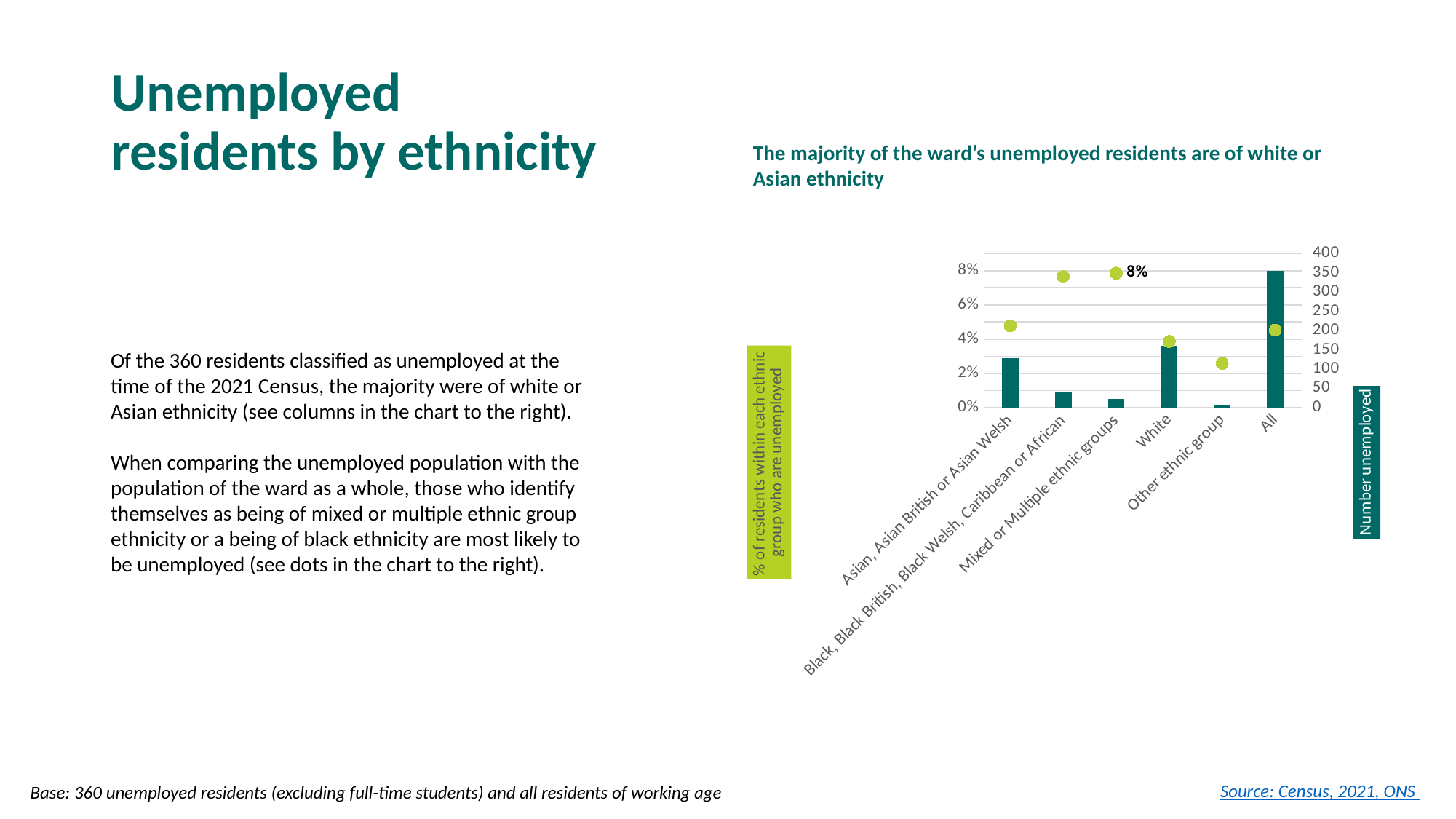
Which category has the lowest dot for the percentage of residents who are unemployed? Other ethnic group Is the number unemployed bar for All greater or less than 300? greater What is the label on the right-hand vertical axis of the chart? Number unemployed Which category has the highest dot for the percentage of residents who are unemployed? Mixed or Multiple ethnic groups How many ethnic group categories are shown along the x axis of the chart? 6 Is the number unemployed bar for Black, Black British, Black Welsh, Caribbean or African greater or less than 100? less Which category has the shortest bar for number unemployed? Other ethnic group Excluding the All category, which ethnic group has the tallest bar for number unemployed? White Which category has the tallest bar for number unemployed? All Which has the taller number unemployed bar: White or Asian, Asian British or Asian Welsh? White What kind of chart is shown on the slide? bar chart with dot markers What percentage of residents in the Mixed or Multiple ethnic groups category are unemployed, according to the data label? 8%